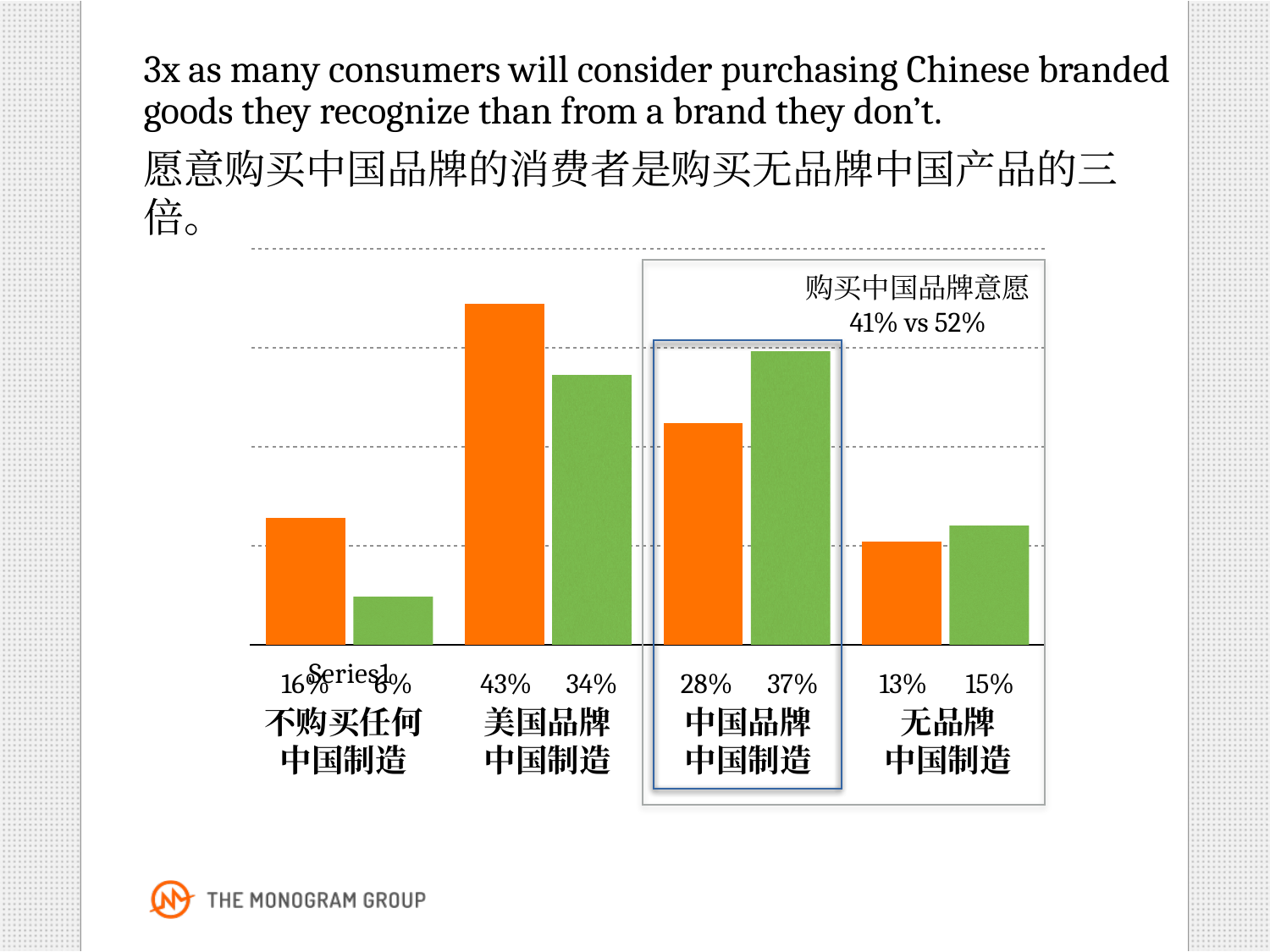
Which category has the lowest green bar? 不购买任何中国制造 How many categories are shown along the x axis of the chart? 4 For 中国品牌中国制造, which bar is larger, the orange or the green? green What type of chart is shown on the slide? bar chart What is the difference between the orange and green bars for 美国品牌中国制造? 9% What is the difference between the green bar for 中国品牌中国制造 and the green bar for 无品牌中国制造? 22% What is the value of the green bar for 中国品牌中国制造? 37% What is the value of the orange bar for 无品牌中国制造? 13% Which category has the highest orange bar? 美国品牌中国制造 What is the value of the orange bar for 美国品牌中国制造? 43% What is the value of the green bar for 不购买任何中国制造? 6% What comparison is written in the annotation box at the top right of the chart? 购买中国品牌意愿 41% vs 52%